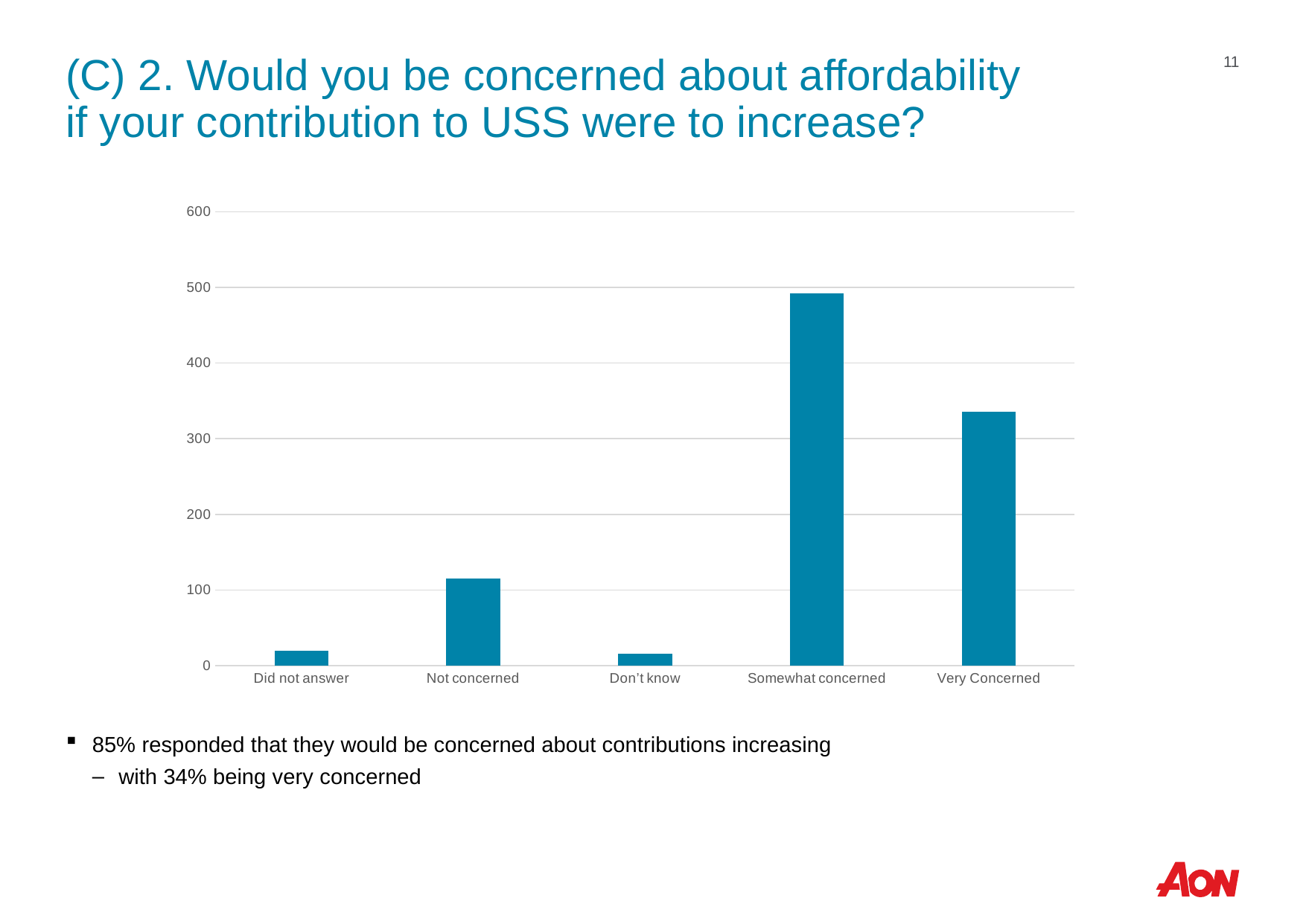
Is the value for Somewhat concerned greater or less than 400? greater How many categories are shown on the x axis of the chart? 5 Which is larger, the value for Not concerned or the value for Don't know? Not concerned What is the label of the last category on the x axis of the chart? Very Concerned What kind of chart is shown on the slide? bar chart Is the value for Very Concerned greater or less than 300? greater Which category has the highest value in the chart? Somewhat concerned Is the value for Did not answer greater or less than 100? less Which is larger, the value for Somewhat concerned or the value for Very Concerned? Somewhat concerned What is the highest value shown on the y axis of the chart? 600